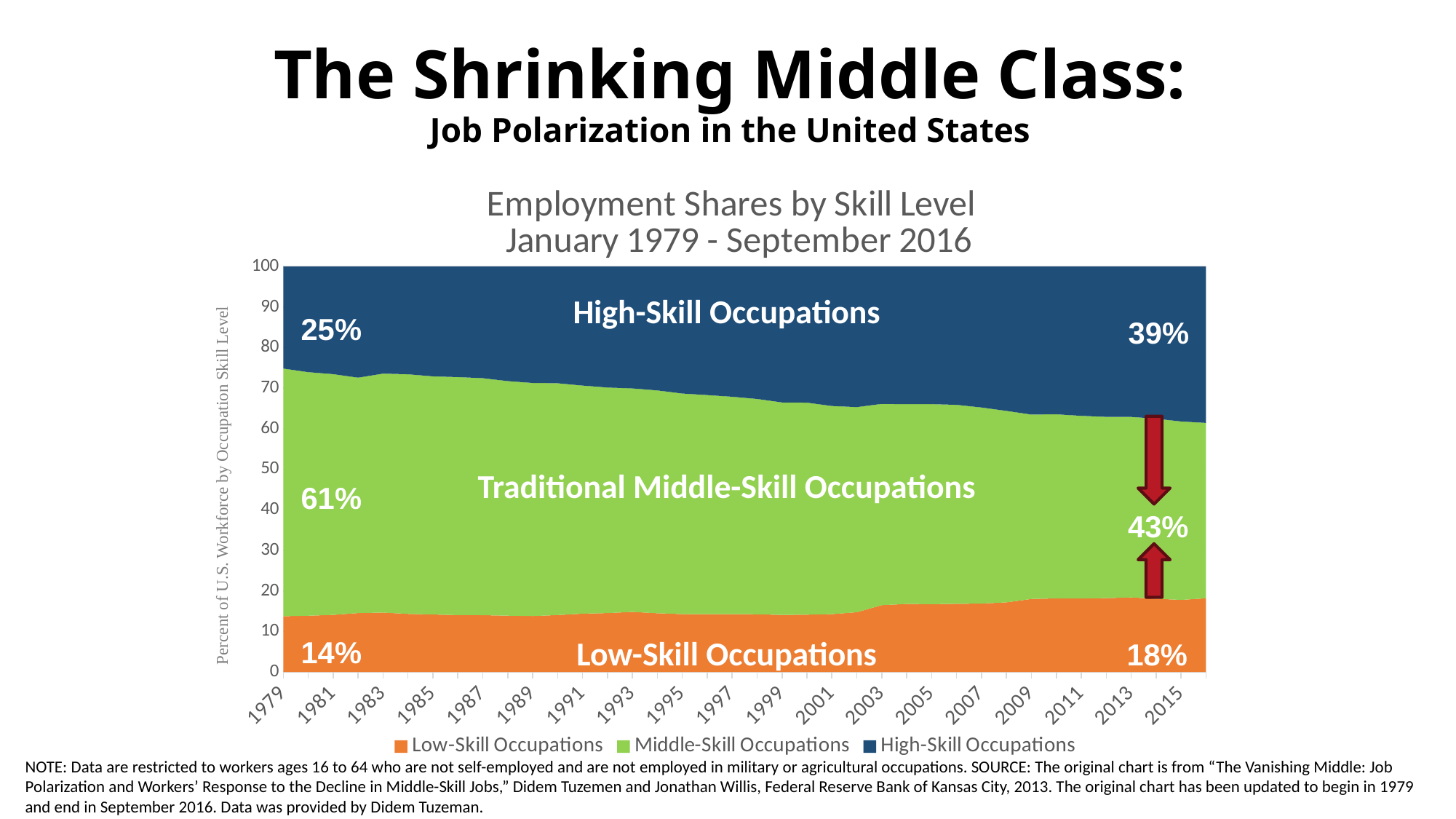
What share of employment did Low-Skill Occupations have at the end of the period (September 2016)? 18% What kind of chart is shown on the slide? Stacked area chart How many series does the legend list? 3 Which skill level had the smallest employment share at the end of the period? Low-Skill Occupations What is the title of the chart? Employment Shares by Skill Level January 1979 - September 2016 What share of employment did Traditional Middle-Skill Occupations have at the start of the period (1979)? 61% Does the share of Traditional Middle-Skill Occupations rise or fall over the period shown? Fall Which skill level had the largest employment share in 1979? Traditional Middle-Skill Occupations By how many percentage points did the Middle-Skill Occupations share fall from 1979 to September 2016? 18 percentage points By how many percentage points did the High-Skill Occupations share rise from 1979 to September 2016? 14 percentage points What share of employment did Traditional Middle-Skill Occupations have at the end of the period (September 2016)? 43% What share of employment did High-Skill Occupations have at the start of the period (1979)? 25%